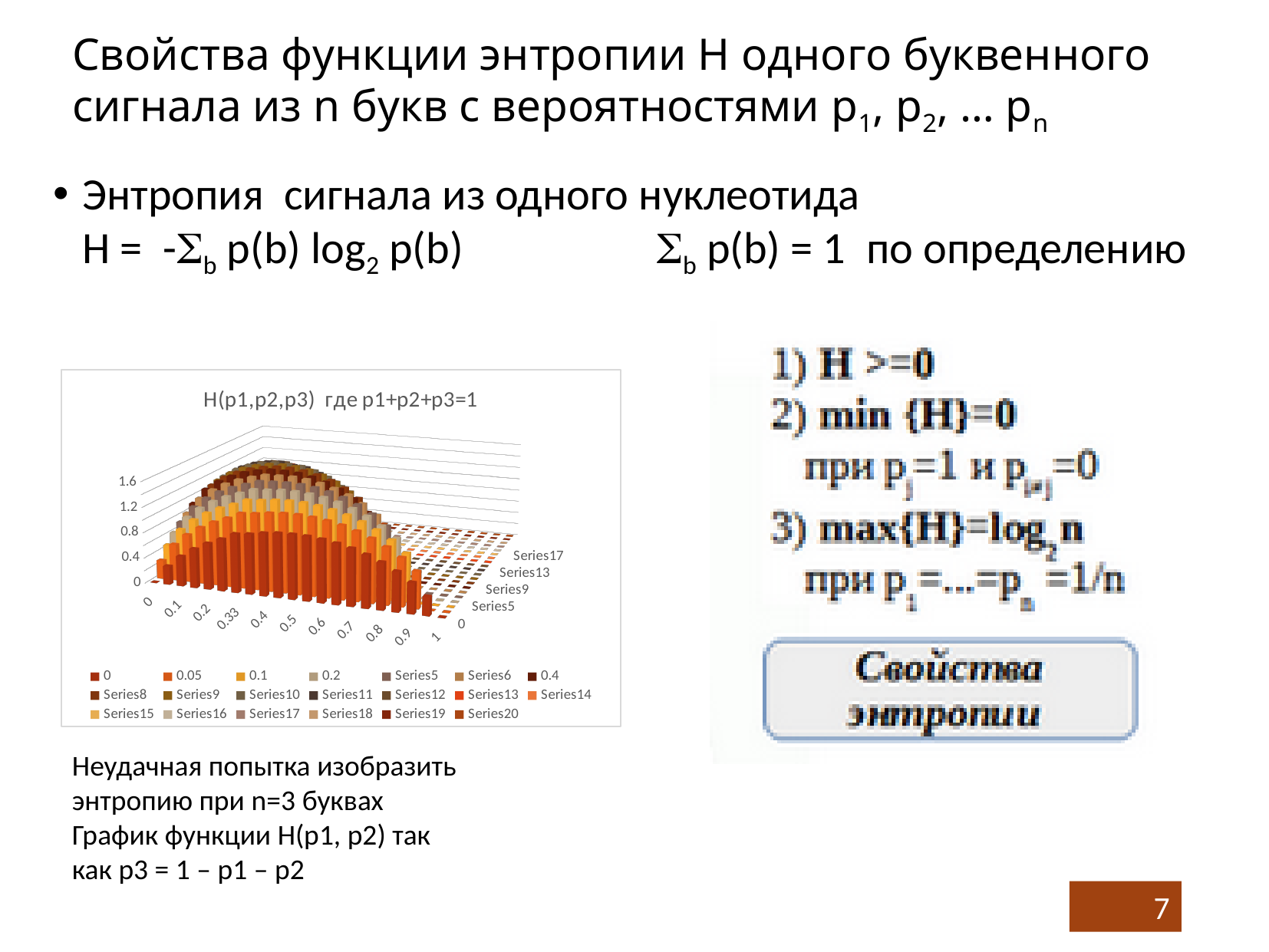
Is the tallest bar in the chart greater or less than 1.2? greater What is the last category label on the chart's x axis? 1 What is the title of the chart on the slide? H(p1,p2,p3) где p1+p2+p3=1 What kind of chart is shown on the slide? bar chart What is the first category label on the chart's x axis? 0 How many series does the chart's legend list? 20 What is the highest tick value shown on the chart's vertical axis? 1.6 How many categories are labelled along the chart's x axis? 11